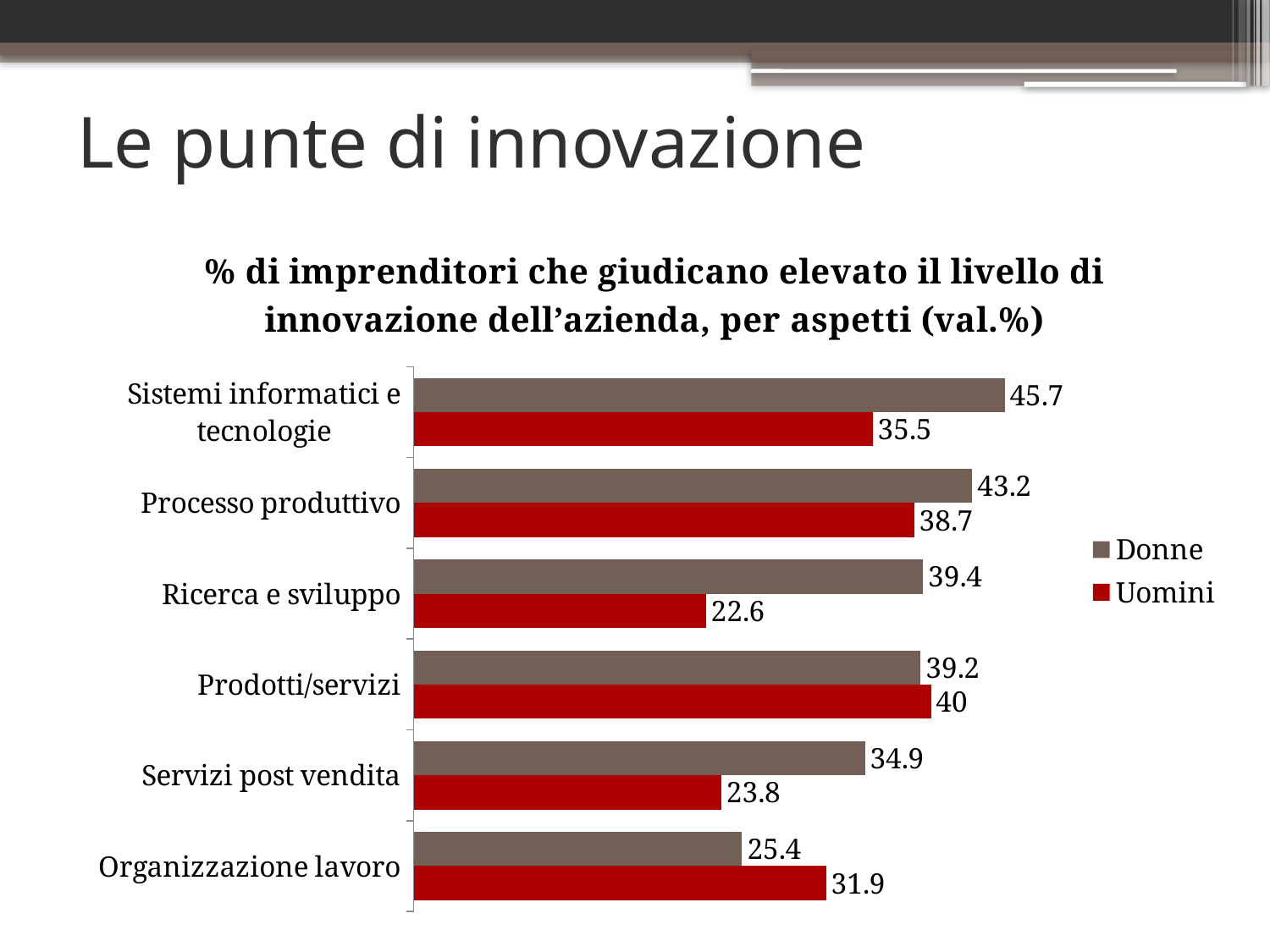
What is the Uomini value for Organizzazione lavoro? 31.9 How many series does the legend list? 2 For Organizzazione lavoro, which is larger: the Donne value or the Uomini value? Uomini What is the difference between the Donne and Uomini values for Servizi post vendita? 11.1 Which category has the lowest Uomini value? Ricerca e sviluppo Which category has the highest Donne value? Sistemi informatici e tecnologie What kind of chart is shown on the slide? Bar chart What is the Uomini value for Ricerca e sviluppo? 22.6 What is the difference between the Donne and Uomini values for Ricerca e sviluppo? 16.8 For Prodotti/servizi, which is larger: the Donne value or the Uomini value? Uomini How many categories are shown in the chart? 6 What is the Donne value for Sistemi informatici e tecnologie? 45.7